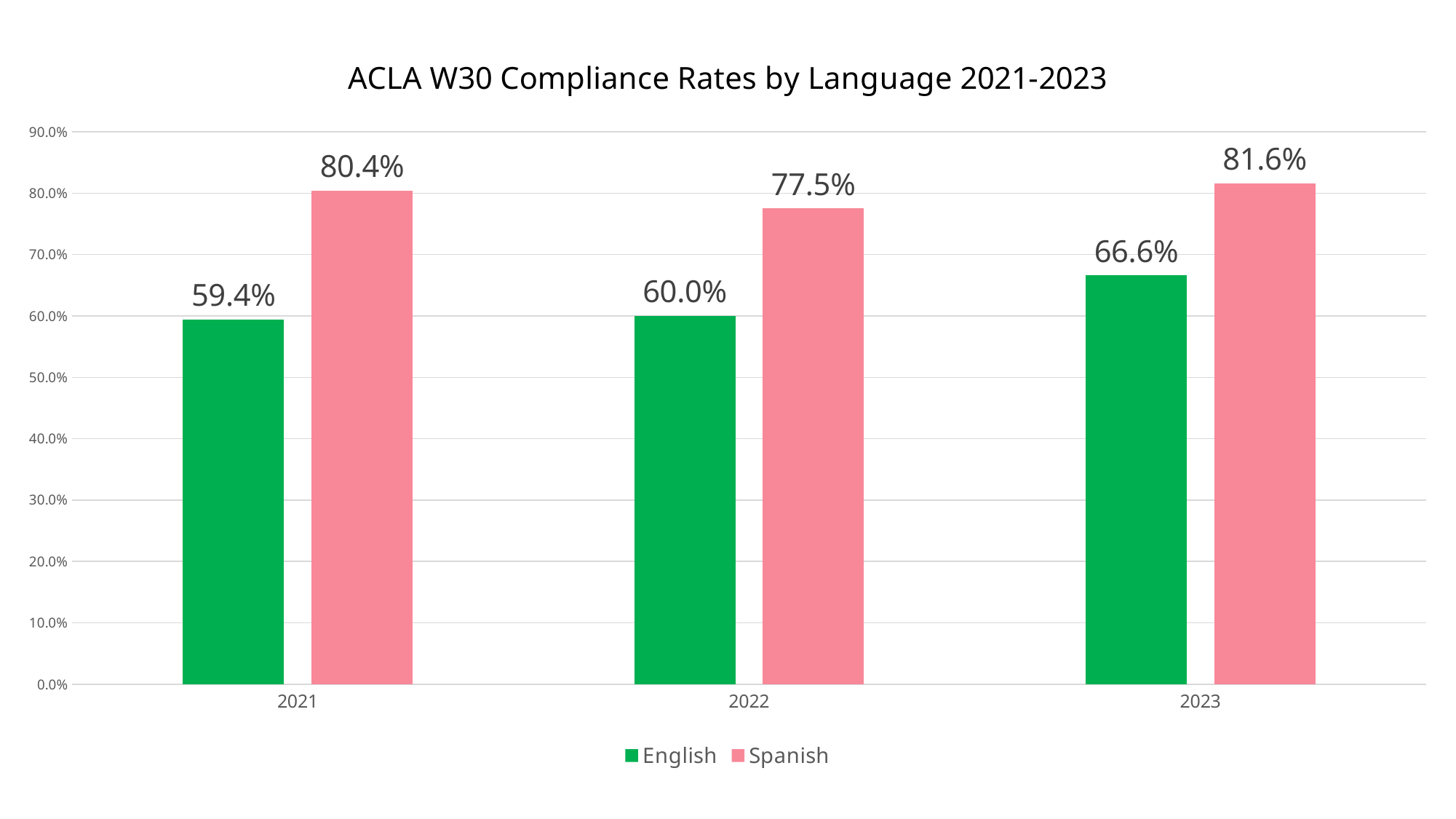
In which year is the English compliance rate highest? 2023 In which year is the Spanish compliance rate lowest? 2022 By how much did the English compliance rate increase from 2022 to 2023? 6.6% How many series does the legend list? 2 What is the difference between the Spanish and English compliance rates in 2021? 21.0% What kind of chart is shown on the slide? Bar chart Is the English compliance rate in 2023 greater or less than 70.0%? less How many years are shown on the x axis? 3 What is the Spanish compliance rate in 2022? 77.5% What is the Spanish compliance rate in 2023? 81.6% What is the English compliance rate in 2021? 59.4% Which language had the higher compliance rate in 2022? Spanish